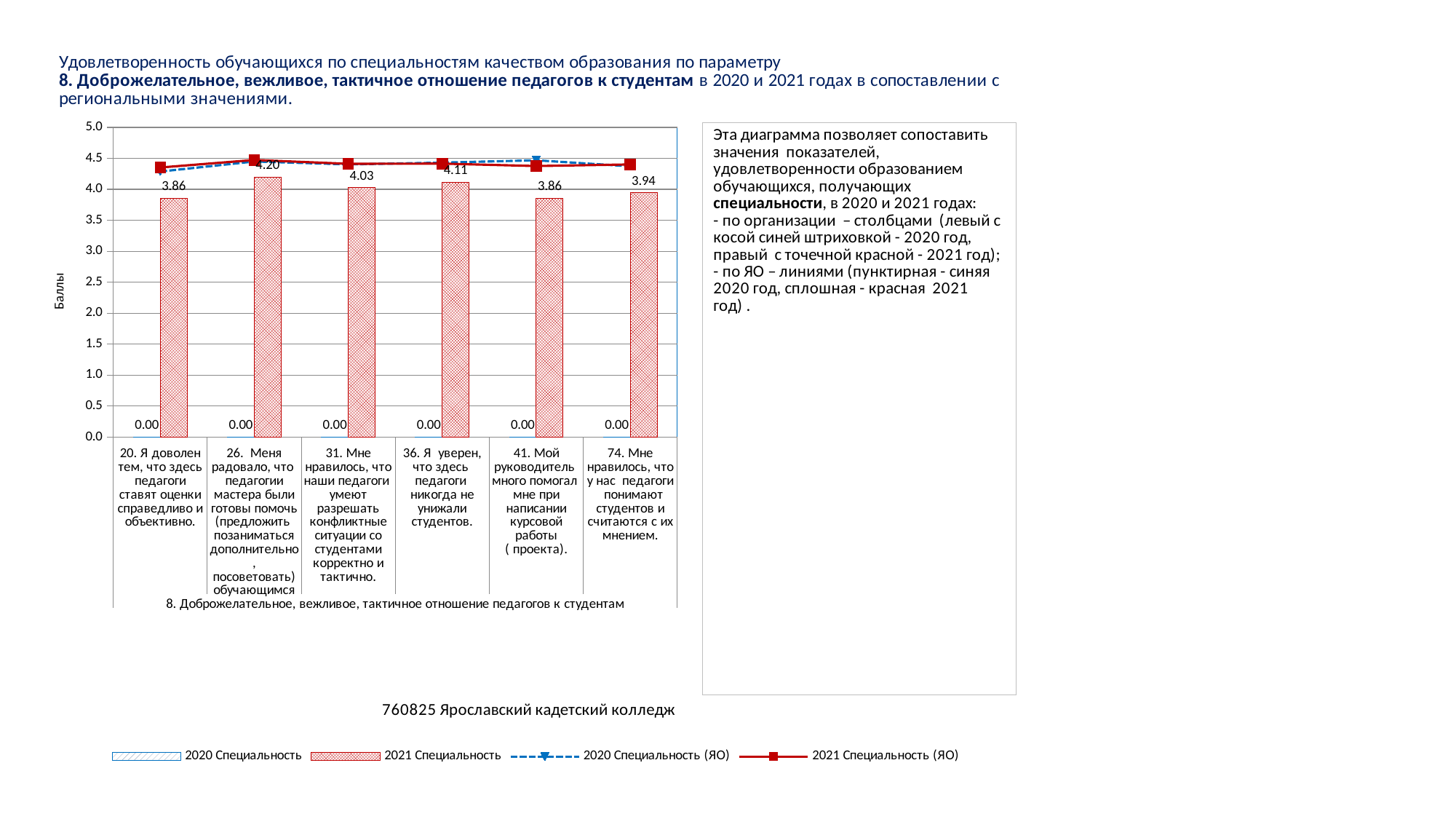
What is the value of the 2020 Специальность bar for category 36 (Я уверен, что здесь педагоги никогда не унижали студентов)? 0.00 What is the value of the 2021 Специальность bar for category 74 (Мне нравилось, что у нас педагоги понимают студентов и считаются с их мнением)? 3.94 What is the value of the 2021 Специальность bar for category 26 (Меня радовало, что педагоги мастера были готовы помочь...)? 4.20 What is the difference between the 2021 Специальность values for category 26 and category 20? 0.34 What kind of chart is shown on the slide? Combined bar and line chart How many series does the legend list? 4 How many categories are shown on the x axis? 6 Which is larger, the 2021 Специальность value for category 31 or for category 36? 36 (4.11) What is the maximum value shown on the vertical axis? 5.0 Which category has the highest 2021 Специальность bar? 26. Меня радовало, что педагоги мастера были готовы помочь Is the 2021 Специальность (ЯО) line value for category 20 greater or less than 4.0? greater What is the label of the vertical axis? Баллы